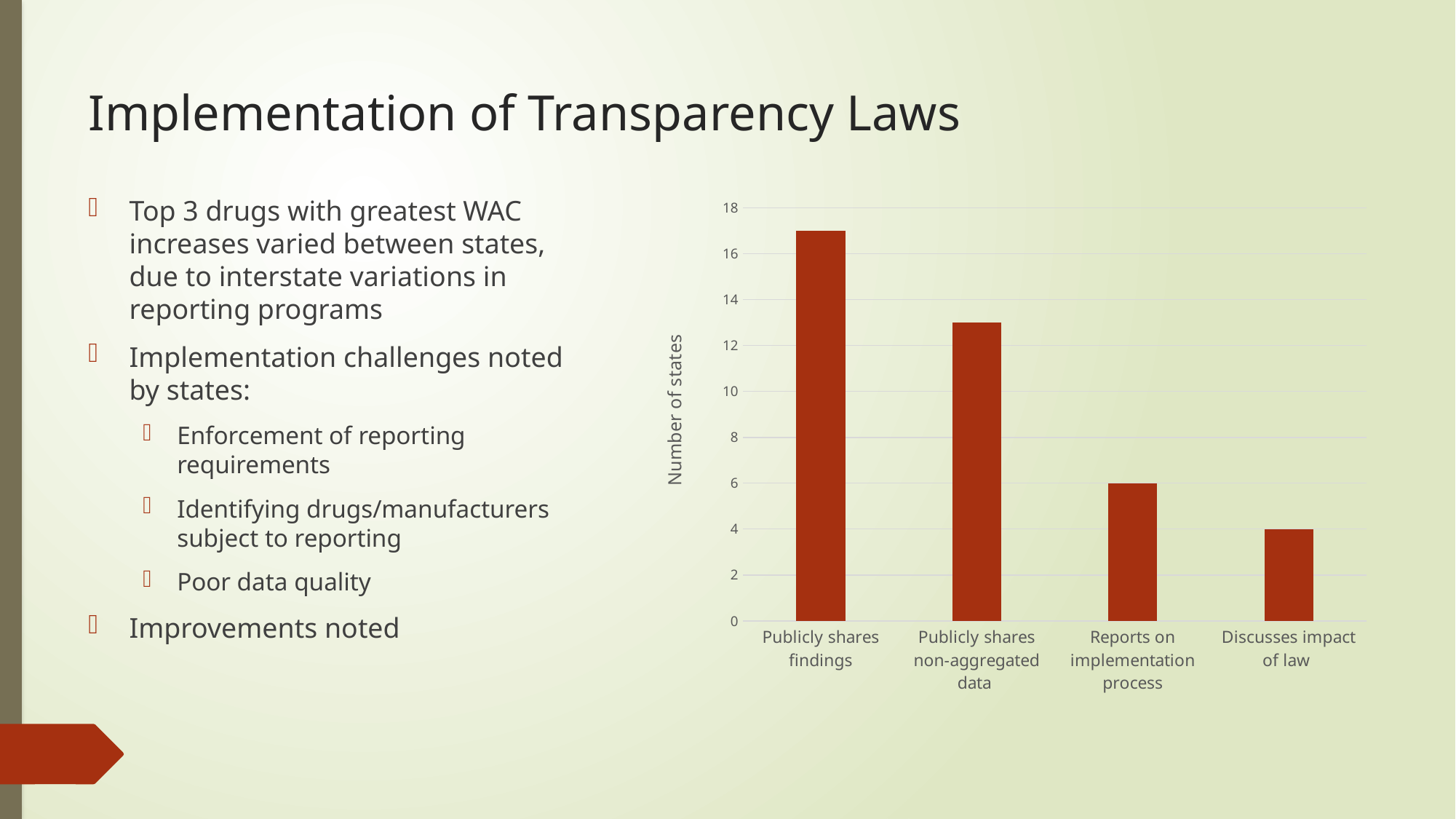
Which has more states: 'Publicly shares non-aggregated data' or 'Reports on implementation process'? Publicly shares non-aggregated data Which category has the lowest number of states? Discusses impact of law What is the number of states for 'Reports on implementation process'? 6 Which category has the highest number of states? Publicly shares findings Do the values rise or fall moving left to right along the x axis? fall What is the label on the vertical axis of the chart? Number of states Is the value for 'Publicly shares non-aggregated data' greater or less than 14? less How many categories are shown on the x axis of the chart? 4 What is the number of states for 'Discusses impact of law'? 4 What is the difference in number of states between 'Reports on implementation process' and 'Discusses impact of law'? 2 What kind of chart is shown on the slide? bar chart Is the value for 'Publicly shares findings' greater or less than 16? greater